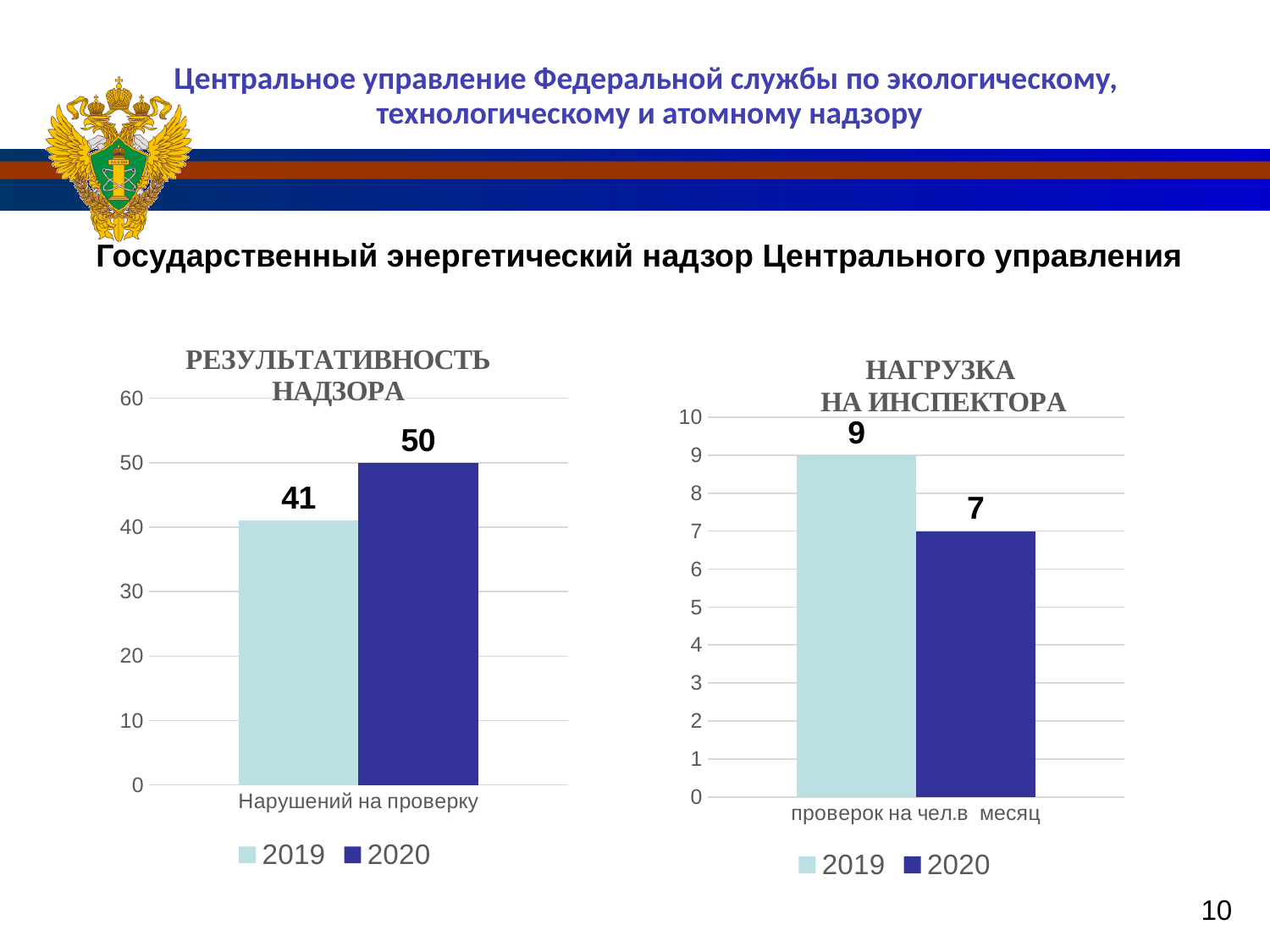
In the 'РЕЗУЛЬТАТИВНОСТЬ НАДЗОРА' chart, what is the difference between the 2020 and 2019 values? 9 In the 'НАГРУЗКА НА ИНСПЕКТОРА' chart, what is the value for 2019? 9 What kind of chart is the 'НАГРУЗКА НА ИНСПЕКТОРА' chart? bar chart In the 'РЕЗУЛЬТАТИВНОСТЬ НАДЗОРА' chart, which year has the higher value? 2020 How many series does the legend of the 'РЕЗУЛЬТАТИВНОСТЬ НАДЗОРА' chart list? 2 In the 'РЕЗУЛЬТАТИВНОСТЬ НАДЗОРА' chart, what is the value for 2019? 41 In the 'НАГРУЗКА НА ИНСПЕКТОРА' chart, what is the value for 2020? 7 In the 'НАГРУЗКА НА ИНСПЕКТОРА' chart, what is the category label on the x axis? проверок на чел.в месяц In the 'НАГРУЗКА НА ИНСПЕКТОРА' chart, which year has the lower value? 2020 In the 'НАГРУЗКА НА ИНСПЕКТОРА' chart, what is the difference between the 2019 and 2020 values? 2 In the 'РЕЗУЛЬТАТИВНОСТЬ НАДЗОРА' chart, what is the value for 2020? 50 In the 'РЕЗУЛЬТАТИВНОСТЬ НАДЗОРА' chart, what is the category label on the x axis? Нарушений на проверку